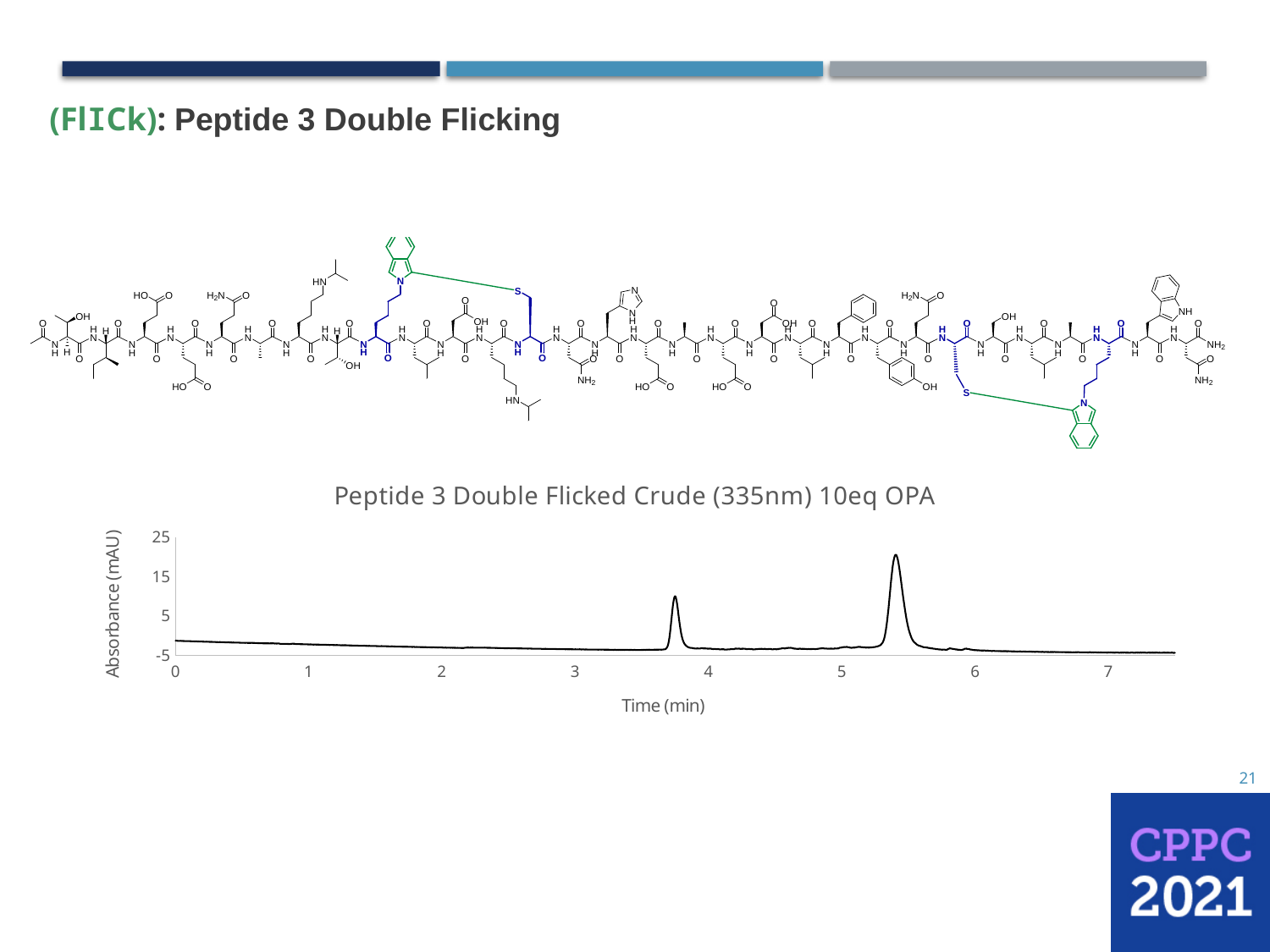
What is the label of the y axis of the chart? Absorbance (mAU) What is the highest value shown on the y axis? 25 What is the title of the chart? Peptide 3 Double Flicked Crude (335nm) 10eq OPA Is the height of the peak near 3.8 min greater or less than 15 mAU? less Is the absorbance at 2 min greater or less than 5 mAU? less Which peak is taller, the one near 3.8 min or the one near 5.4 min? the one near 5.4 min Is the height of the peak near 5.4 min greater or less than 15 mAU? greater How many major peaks appear in the chromatogram? 2 What kind of chart is shown on the slide? line chart What is the lowest value shown on the y axis? -5